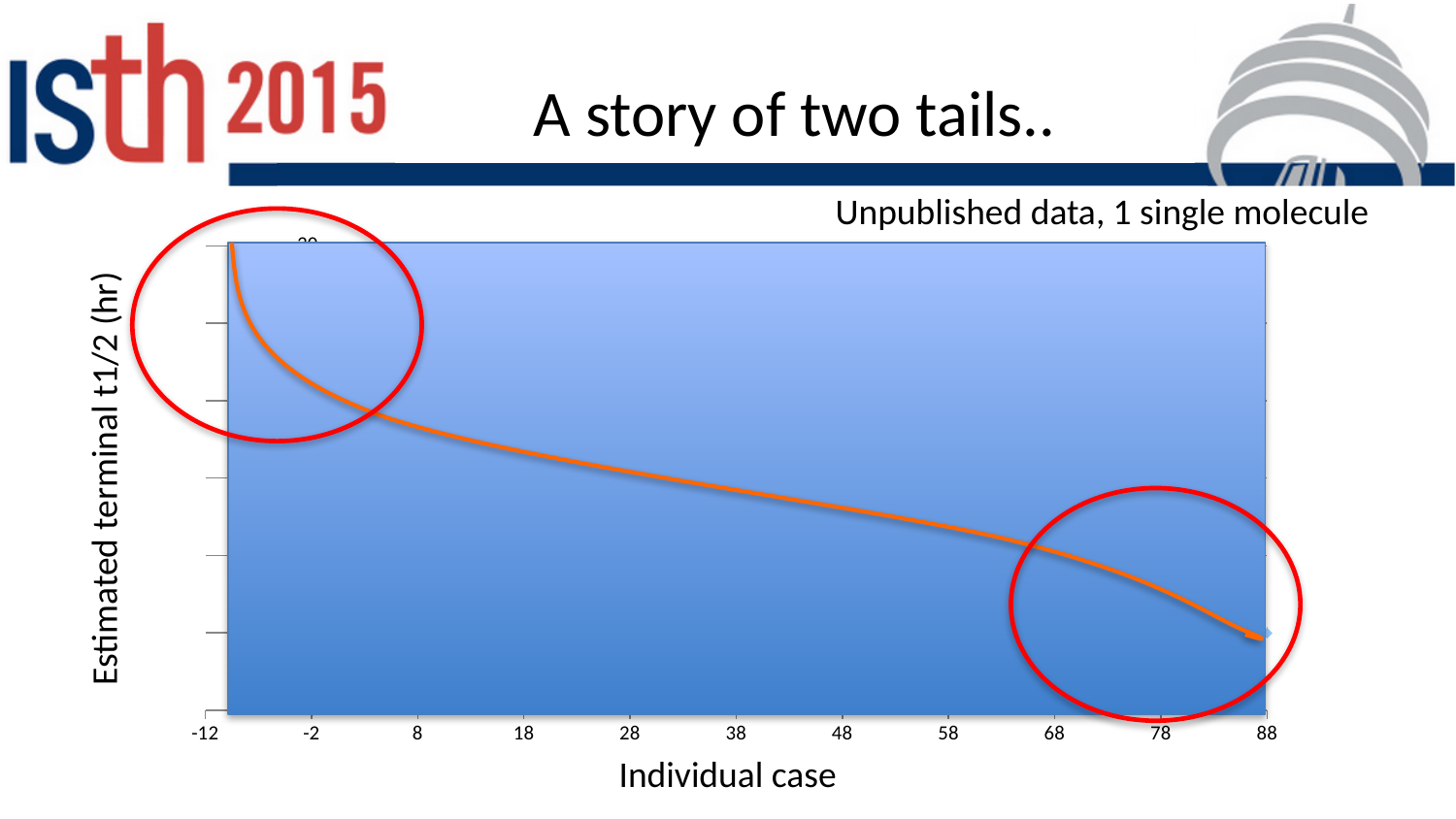
What is the highest value shown on the x axis of the chart? 88 How many tick labels are printed along the x axis of the chart? 11 What is the lowest value shown on the x axis of the chart? -12 What is the label of the x axis of the chart? Individual case At which end of the x axis does the curve reach its highest point, the left end or the right end? left end How many red circles are drawn on the chart to highlight the tails of the curve? 2 Is the plotted value at individual case 8 higher or lower than the plotted value at individual case 68? higher Do the values on the chart rise or fall as the individual case number increases along the x axis? fall What is the step between consecutive tick labels on the x axis of the chart? 10 What kind of chart is shown on the slide? line chart What is the label of the y axis of the chart? Estimated terminal t1/2 (hr) Is the plotted value at individual case 88 higher or lower than the plotted value at individual case -2? lower